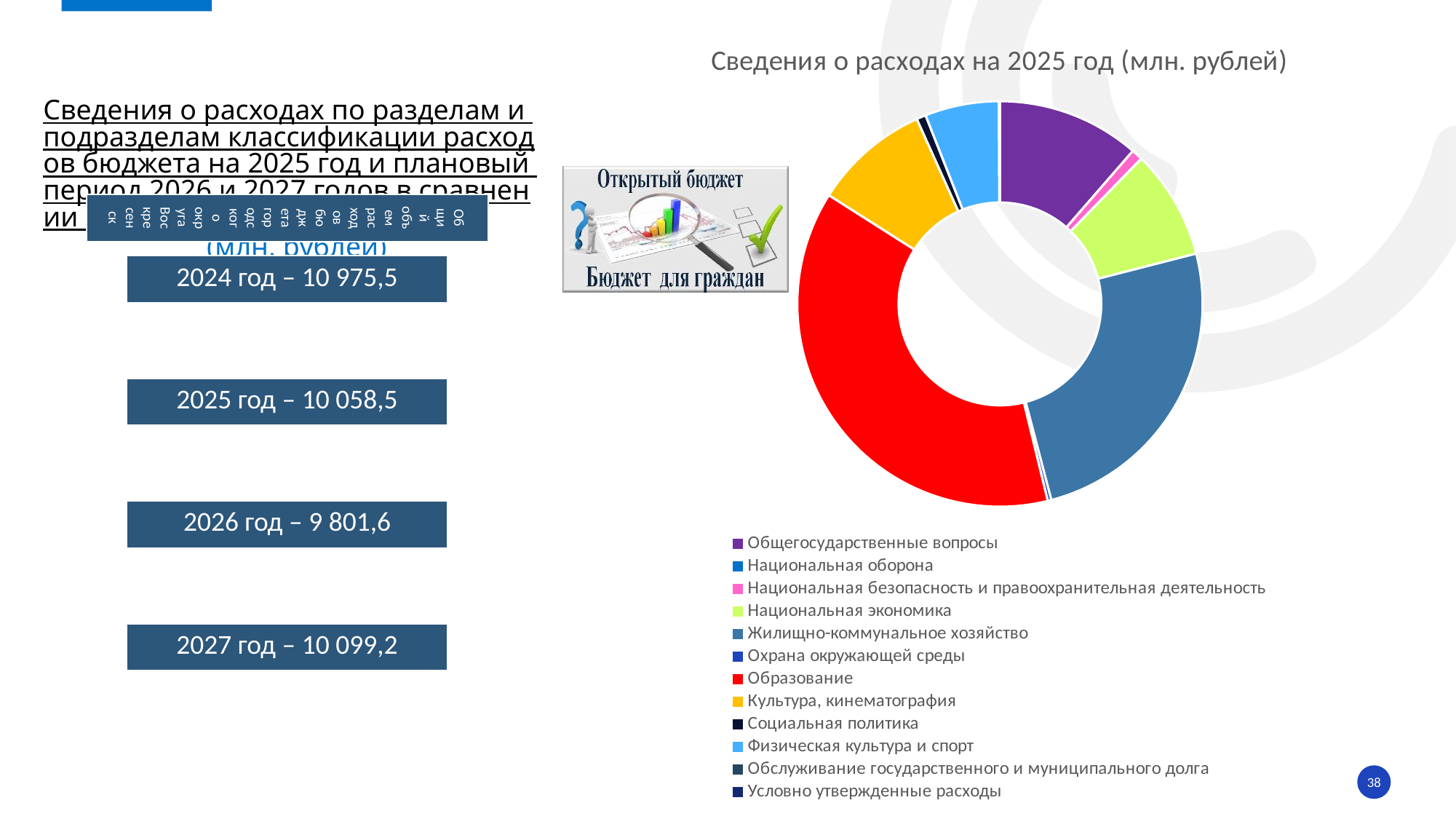
What kind of chart is shown on the slide? Doughnut (pie) chart What is the title of the chart on the slide? Сведения о расходах на 2025 год (млн. рублей) What colour represents Образование in the chart? Red Which category has the largest slice in the chart? Образование How many categories does the chart's legend list? 12 Which slice is larger: Образование or Жилищно-коммунальное хозяйство? Образование Which slice is larger: Национальная экономика or Социальная политика? Национальная экономика Which slice is larger: Культура, кинематография or Физическая культура и спорт? Культура, кинематография Which category has the second largest slice in the chart? Жилищно-коммунальное хозяйство